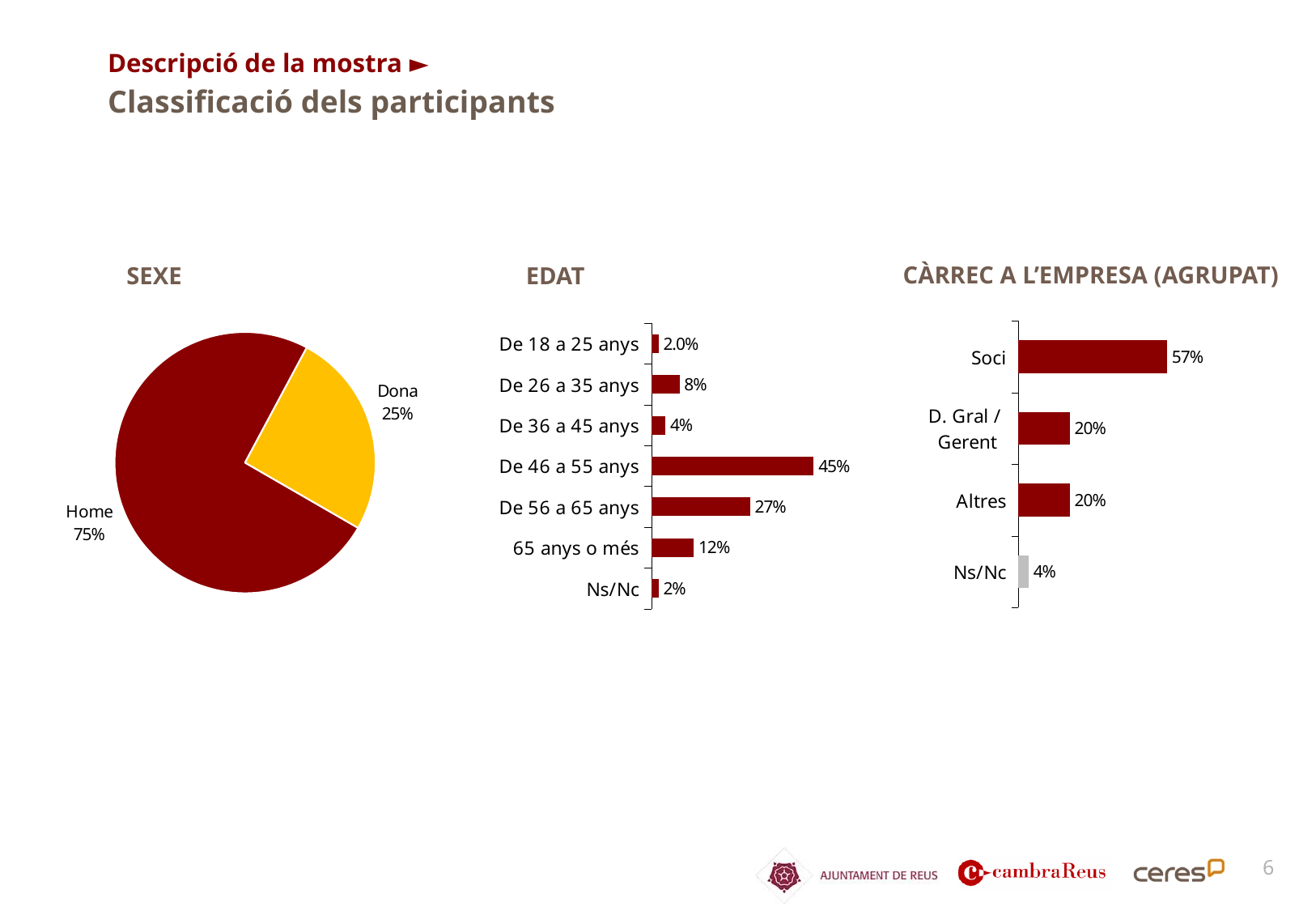
In the EDAT chart, which is larger, De 26 a 35 anys or De 36 a 45 anys? De 26 a 35 anys In the CÀRREC A L'EMPRESA (AGRUPAT) chart, what is the difference between Soci and Altres? 37% In the CÀRREC A L'EMPRESA (AGRUPAT) chart, which category has the lowest value? Ns/Nc In the CÀRREC A L'EMPRESA (AGRUPAT) chart, what is the value for Soci? 57% In the SEXE chart, what share of participants are Dona? 25% In the EDAT chart, what is the value for De 46 a 55 anys? 45% In the EDAT chart, how many categories are shown? 7 In the SEXE chart, what share of participants are Home? 75% In the EDAT chart, which age group has the highest value? De 46 a 55 anys What kind of chart is the SEXE chart? pie chart In the EDAT chart, what is the difference between De 56 a 65 anys and 65 anys o més? 15% What kind of chart is the EDAT chart? bar chart